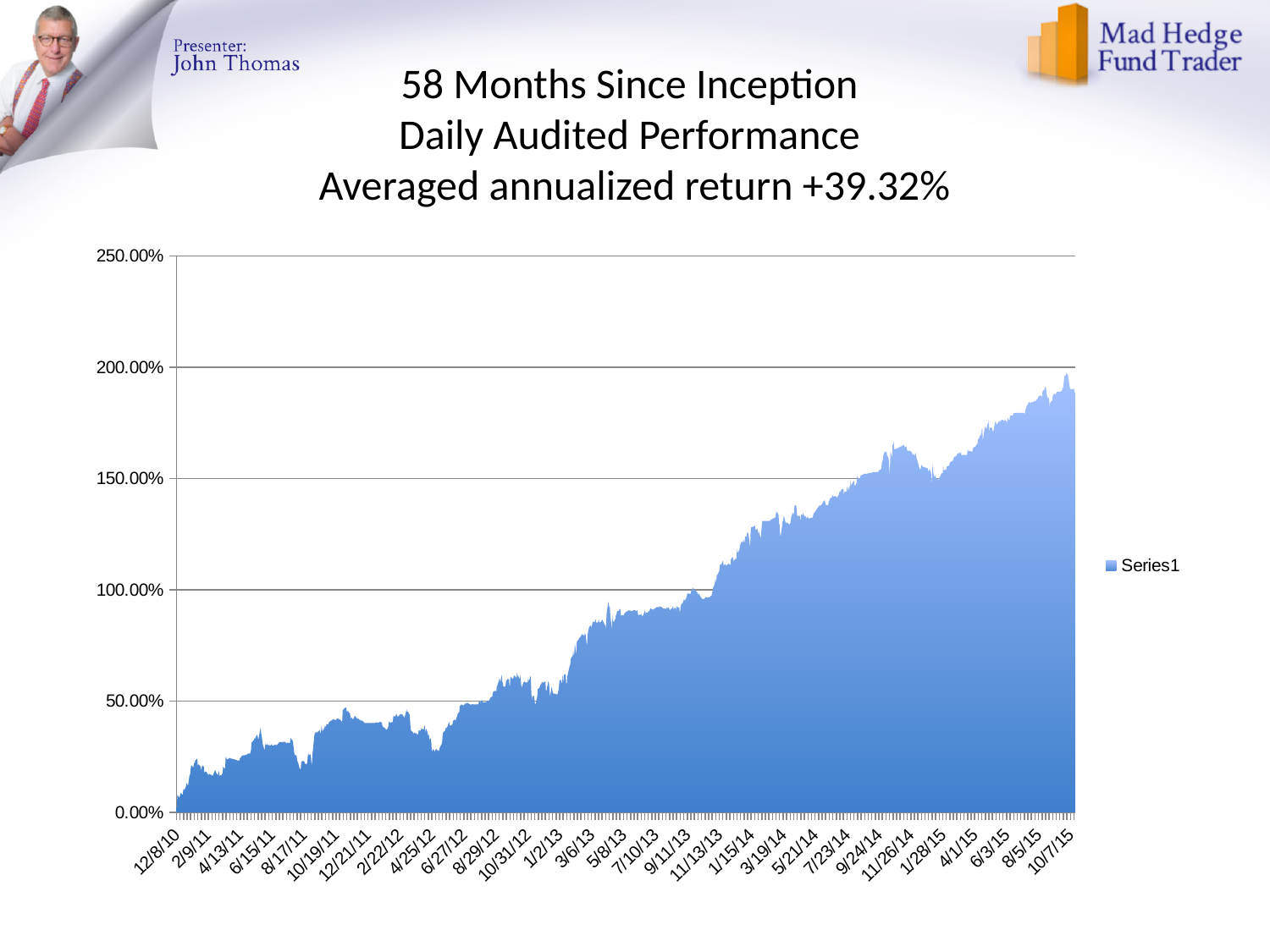
What is the highest value shown on the vertical axis? 250.00% Is the value at 1/15/14 greater or less than 100%? greater What kind of chart is shown on the slide? Area chart Is the value at 12/8/10 greater or less than 50%? less Is the value at 10/7/15 greater or less than 150%? greater Overall, do the values rise or fall from 12/8/10 to 10/7/15? Rise What is the name of the series shown in the legend? Series1 How many series does the chart legend list? 1